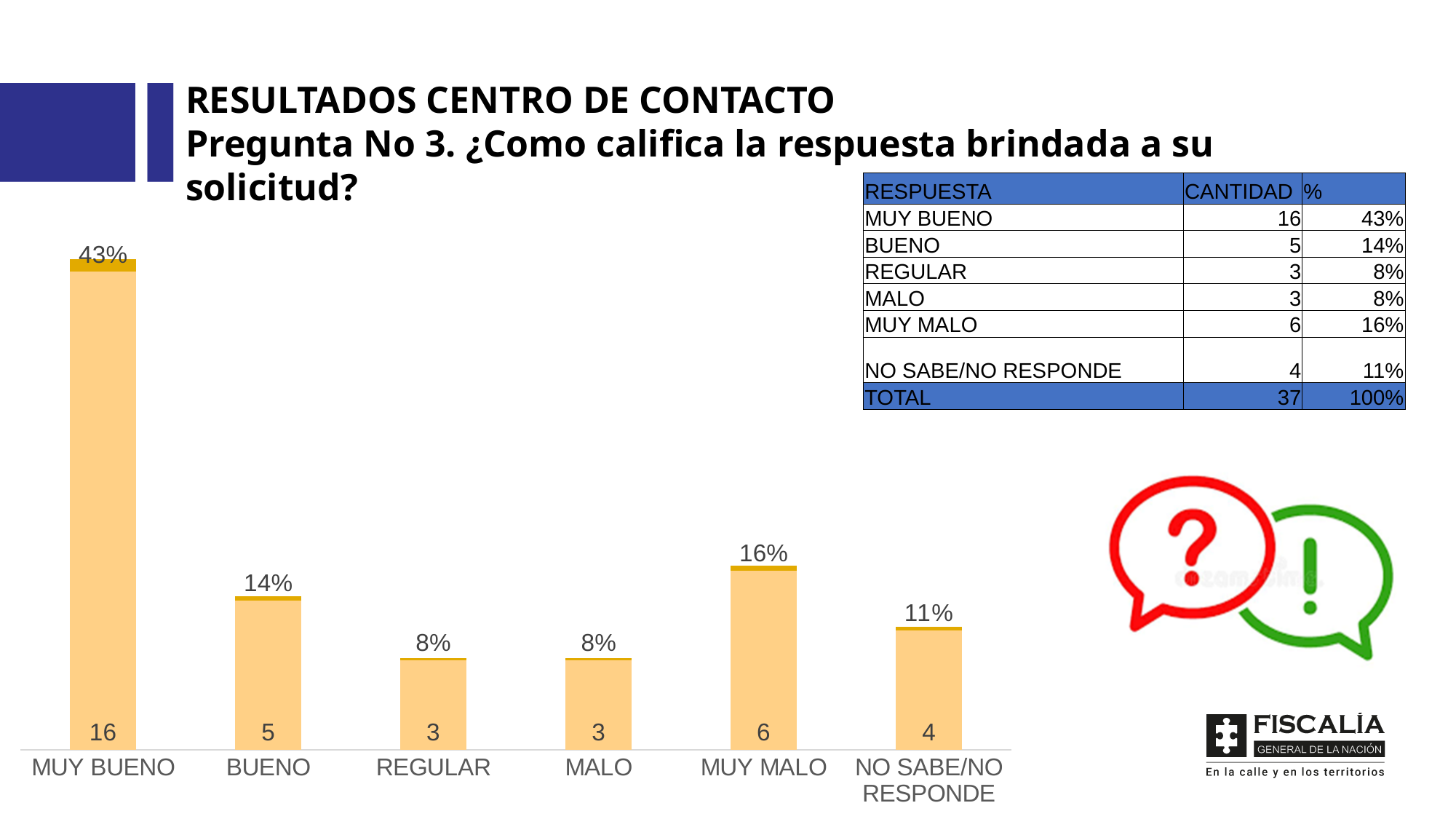
What is the total count shown in the table on the slide? 37 What count is shown inside the bar for BUENO? 5 Which two categories share the same percentage of 8%? REGULAR and MALO Which is larger, the value for BUENO or the value for MUY MALO? MUY MALO What is the difference between the counts for MUY MALO and NO SABE/NO RESPONDE? 2 Which category has the highest bar in the chart? MUY BUENO What percentage is shown for NO SABE/NO RESPONDE? 11% What is the difference in percentage points between MUY BUENO and BUENO? 29 What kind of chart is shown on the slide? bar chart How many categories are shown on the x axis of the chart? 6 What count is shown inside the bar for MUY MALO? 6 What percentage is shown for MUY BUENO in the chart? 43%